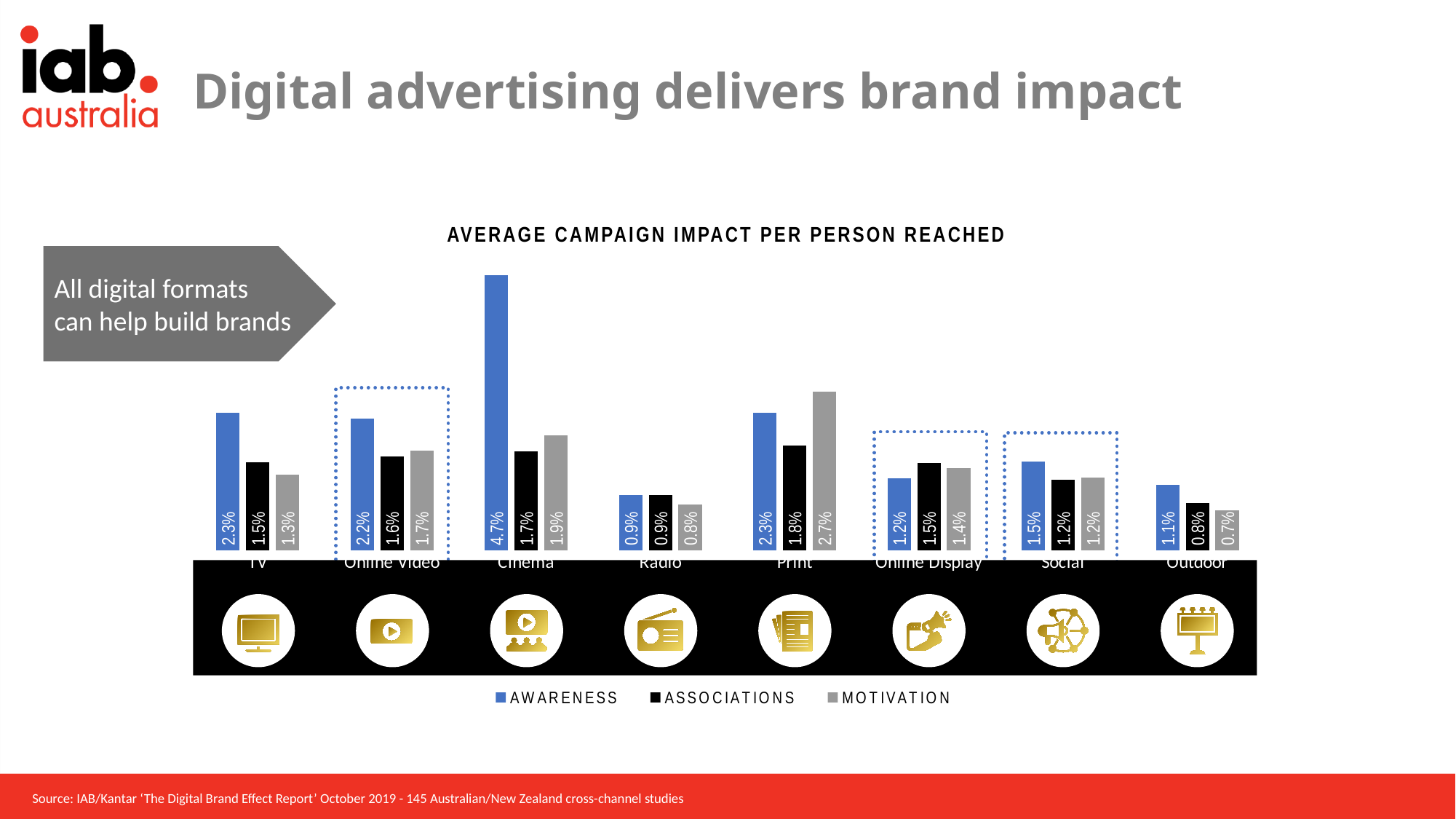
What is the difference between the Awareness values for Cinema and TV? 2.4% Which series is shown in blue in the legend? AWARENESS How many categories are shown on the x axis? 8 What is the Associations value for Online Video? 1.6% Which is larger, the Motivation value for Print or the Motivation value for Cinema? Print What kind of chart is shown? Bar chart Which category has the lowest Motivation value? Outdoor What is the Awareness value for Cinema? 4.7% How many series does the legend list? 3 What is the title of the chart? AVERAGE CAMPAIGN IMPACT PER PERSON REACHED Which category has the highest Awareness value? Cinema What is the Motivation value for Print? 2.7%